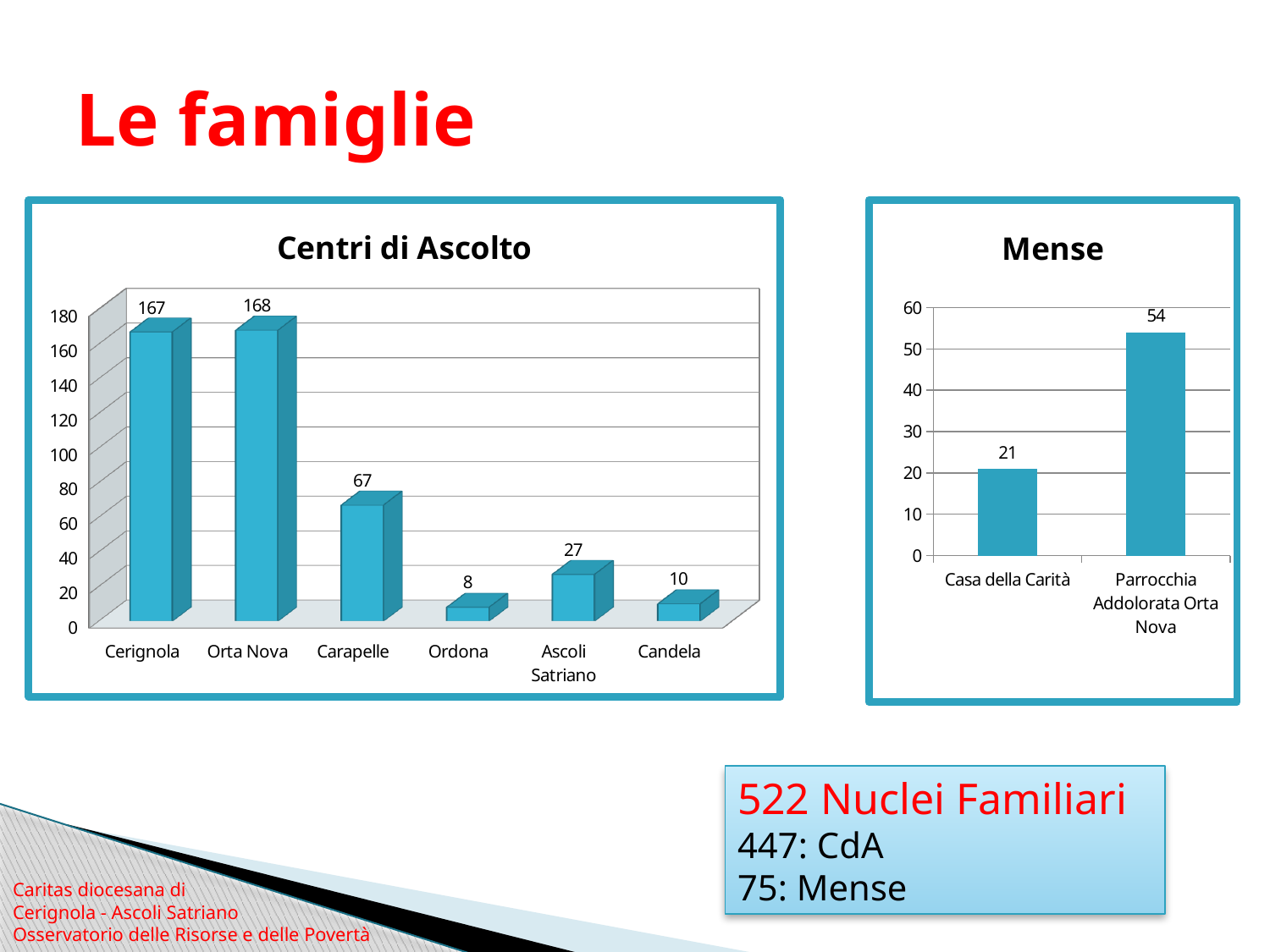
In the Mense chart, is the value for Parrocchia Addolorata Orta Nova greater or less than 50? greater In the Centri di Ascolto chart, what is the value for Carapelle? 67 How many categories are shown in the Centri di Ascolto chart? 6 In the Centri di Ascolto chart, what is the difference between the values for Cerignola and Carapelle? 100 In the Centri di Ascolto chart, which category has the highest value? Orta Nova In the Mense chart, what is the difference between the values for Parrocchia Addolorata Orta Nova and Casa della Carità? 33 In the Centri di Ascolto chart, which category has the lowest value? Ordona In the Mense chart, what is the value for Parrocchia Addolorata Orta Nova? 54 What kind of chart is the Centri di Ascolto chart? Bar chart In the Centri di Ascolto chart, what is the value for Ascoli Satriano? 27 In the Centri di Ascolto chart, which is larger, the value for Candela or the value for Ordona? Candela In the Mense chart, what is the value for Casa della Carità? 21